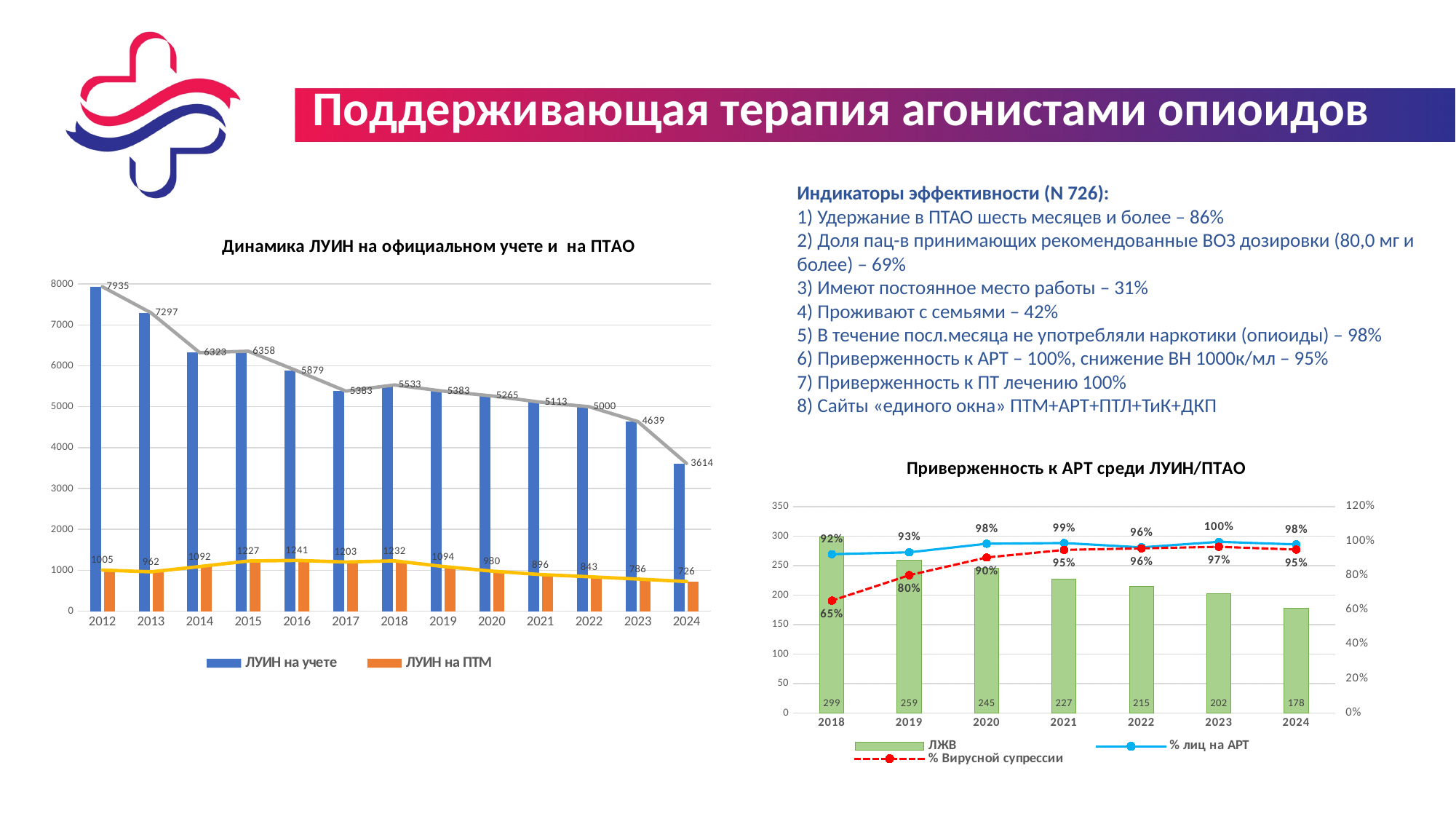
In the chart 'Приверженность к АРТ среди ЛУИН/ПТАО', how many series does the legend list? 3 In the chart 'Динамика ЛУИН на официальном учете и на ПТАО', what is the difference between 'ЛУИН на учете' in 2023 and in 2024? 1025 In the chart 'Динамика ЛУИН на официальном учете и на ПТАО', what is the value for 'ЛУИН на учете' in 2012? 7935 In the chart 'Приверженность к АРТ среди ЛУИН/ПТАО', what is the value for 'ЛЖВ' in 2021? 227 In the chart 'Приверженность к АРТ среди ЛУИН/ПТАО', which is larger: 'ЛЖВ' in 2018 or in 2024? 2018 In the chart 'Динамика ЛУИН на официальном учете и на ПТАО', what is the value for 'ЛУИН на ПТМ' in 2016? 1241 In the chart 'Приверженность к АРТ среди ЛУИН/ПТАО', what is the '% Вирусной супрессии' value in 2018? 65% In the chart 'Приверженность к АРТ среди ЛУИН/ПТАО', in which year is '% лиц на АРТ' highest? 2023 In the chart 'Динамика ЛУИН на официальном учете и на ПТАО', how many years are shown on the x axis? 13 In the chart 'Динамика ЛУИН на официальном учете и на ПТАО', how many series does the legend list? 2 In the chart 'Динамика ЛУИН на официальном учете и на ПТАО', which year has the lowest value for 'ЛУИН на учете'? 2024 In the chart 'Динамика ЛУИН на официальном учете и на ПТАО', does the value for 'ЛУИН на учете' generally rise or fall from 2012 to 2024? fall